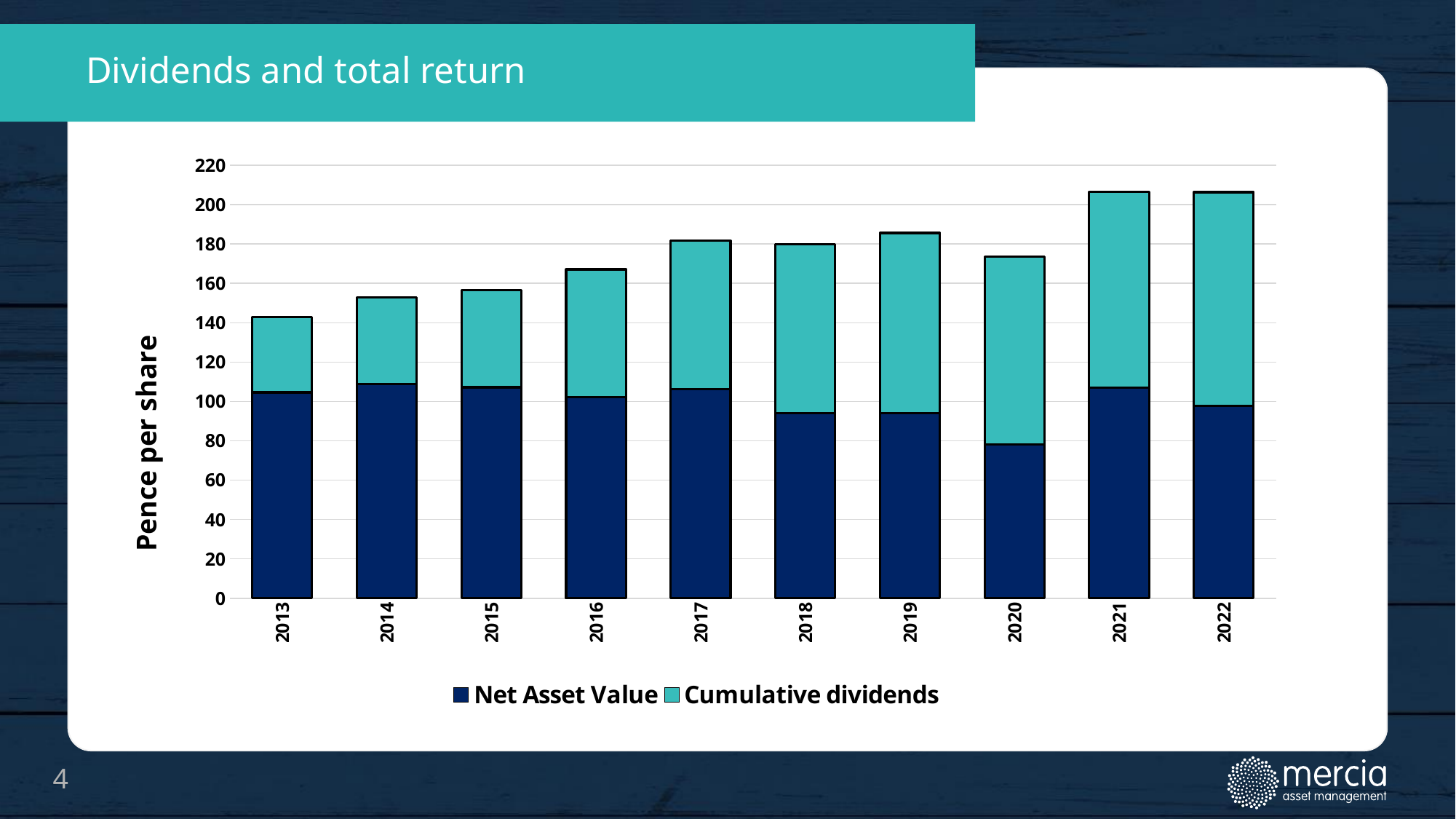
Is the Net Asset Value for 2018 greater or less than 100? less What is the label on the vertical axis of the chart? Pence per share How many series does the chart legend list? 2 Which year has the lowest total bar height in the chart? 2013 Which year has the lowest Net Asset Value in the chart? 2020 Is the Net Asset Value for 2020 greater or less than 100? less Is the total bar height for 2021 greater or less than 200? greater Do the total bar heights generally rise or fall from 2013 to 2022? rise What kind of chart is shown on the slide? Stacked bar chart How many years are shown on the x axis of the chart? 10 Which is larger, the total bar for 2013 or the total bar for 2019? 2019